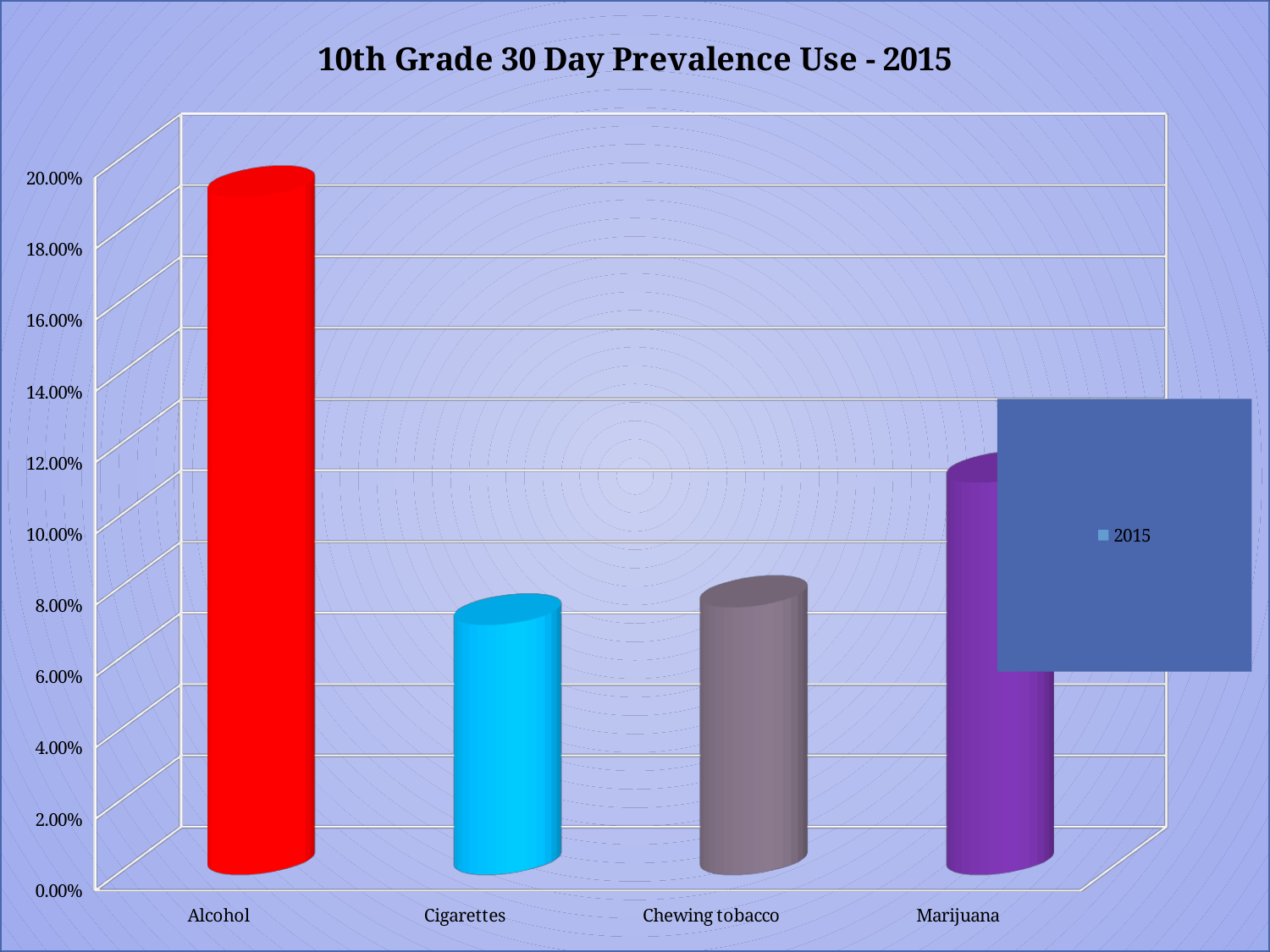
What series name appears in the legend? 2015 Which category has the highest value? Alcohol What kind of chart is shown on the slide? bar chart Which is larger, the value for Alcohol or the value for Marijuana? Alcohol Is the value for Cigarettes greater or less than 10.00%? less How many series does the legend list? 1 Is the value for Chewing tobacco greater or less than 10.00%? less Which is larger, the value for Marijuana or the value for Cigarettes? Marijuana What is the title of the chart? 10th Grade 30 Day Prevalence Use - 2015 Is the value for Alcohol greater or less than 18.00%? greater How many categories are shown on the x axis of the chart? 4